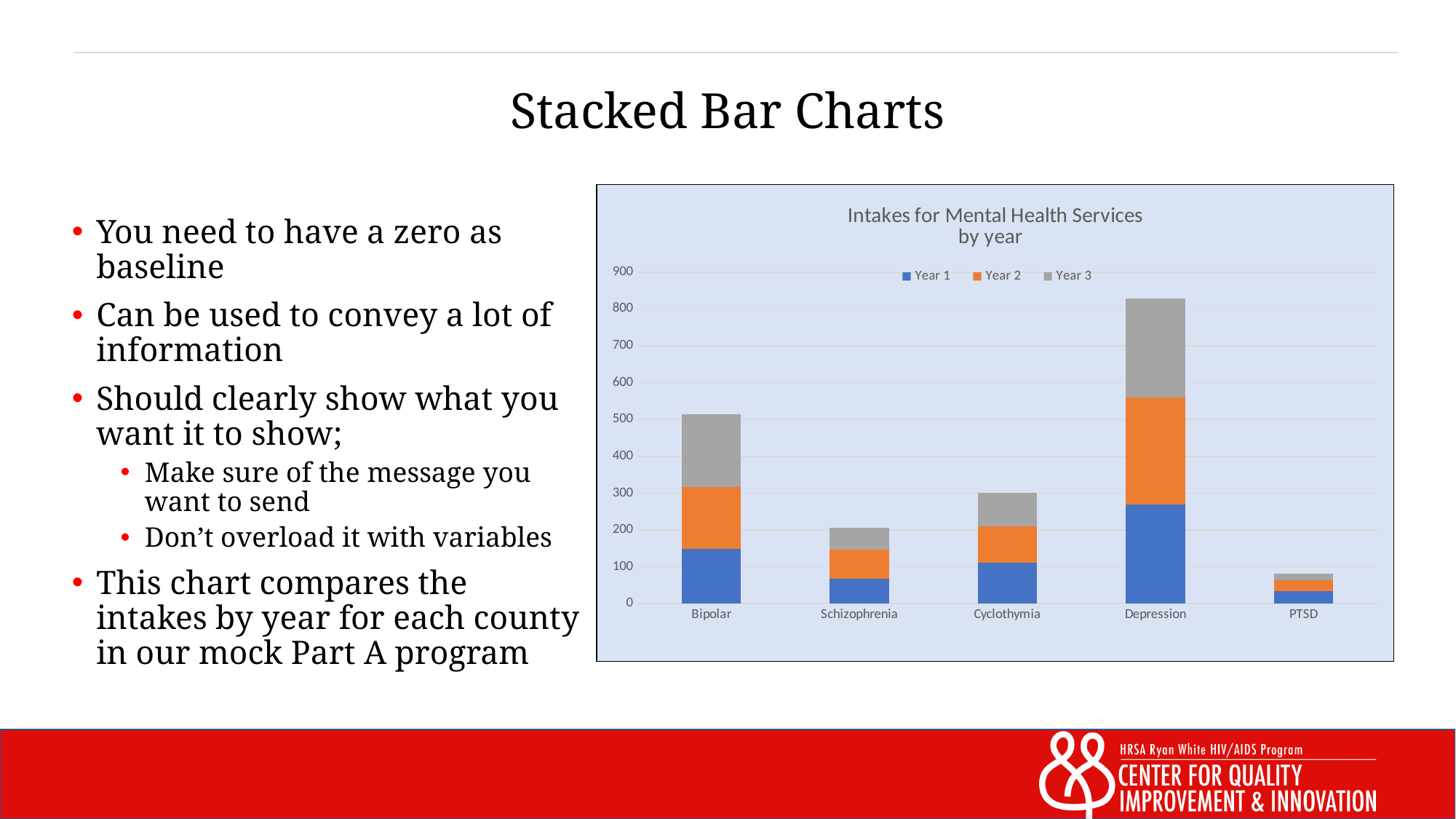
How many categories are shown on the x axis of the chart? 5 Which category has the shortest stacked bar in the chart? PTSD What kind of chart is shown on the slide? Stacked bar chart Which category has the tallest stacked bar in the chart? Depression How many series does the chart's legend list? 3 What are the series names listed in the chart's legend? Year 1, Year 2, Year 3 Is the total stacked value for Depression greater or less than 700? greater Which stacked bar is taller, Bipolar or Cyclothymia? Bipolar Is the total stacked value for PTSD greater or less than 100? less Which stacked bar is taller, Schizophrenia or Cyclothymia? Cyclothymia Is the Year 1 value for Depression greater or less than 200? greater What is the title of the chart? Intakes for Mental Health Services by year